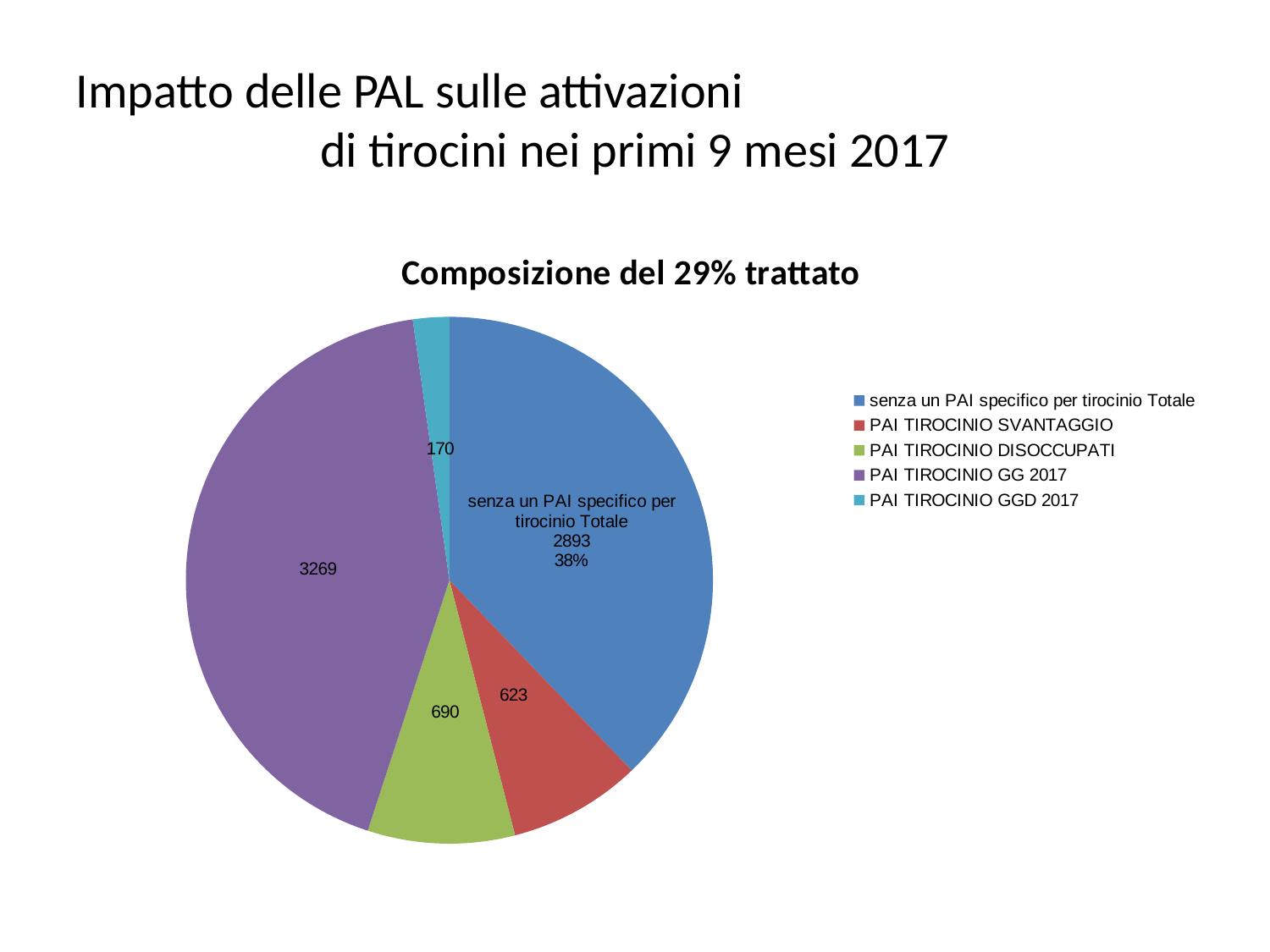
Which is larger, PAI TIROCINIO DISOCCUPATI or PAI TIROCINIO SVANTAGGIO? PAI TIROCINIO DISOCCUPATI What is the value for senza un PAI specifico per tirocinio Totale? 2893 What is the value for PAI TIROCINIO GG 2017? 3269 How many slices does the pie chart have? 5 What is the title of the chart? Composizione del 29% trattato Which category has the smallest slice? PAI TIROCINIO GGD 2017 What share of the pie does senza un PAI specifico per tirocinio Totale represent? 38% What type of chart is shown on the slide? pie chart What is the value for PAI TIROCINIO SVANTAGGIO? 623 What is the difference between the values for PAI TIROCINIO GG 2017 and senza un PAI specifico per tirocinio Totale? 376 What is the value for PAI TIROCINIO GGD 2017? 170 Which category has the largest slice? PAI TIROCINIO GG 2017